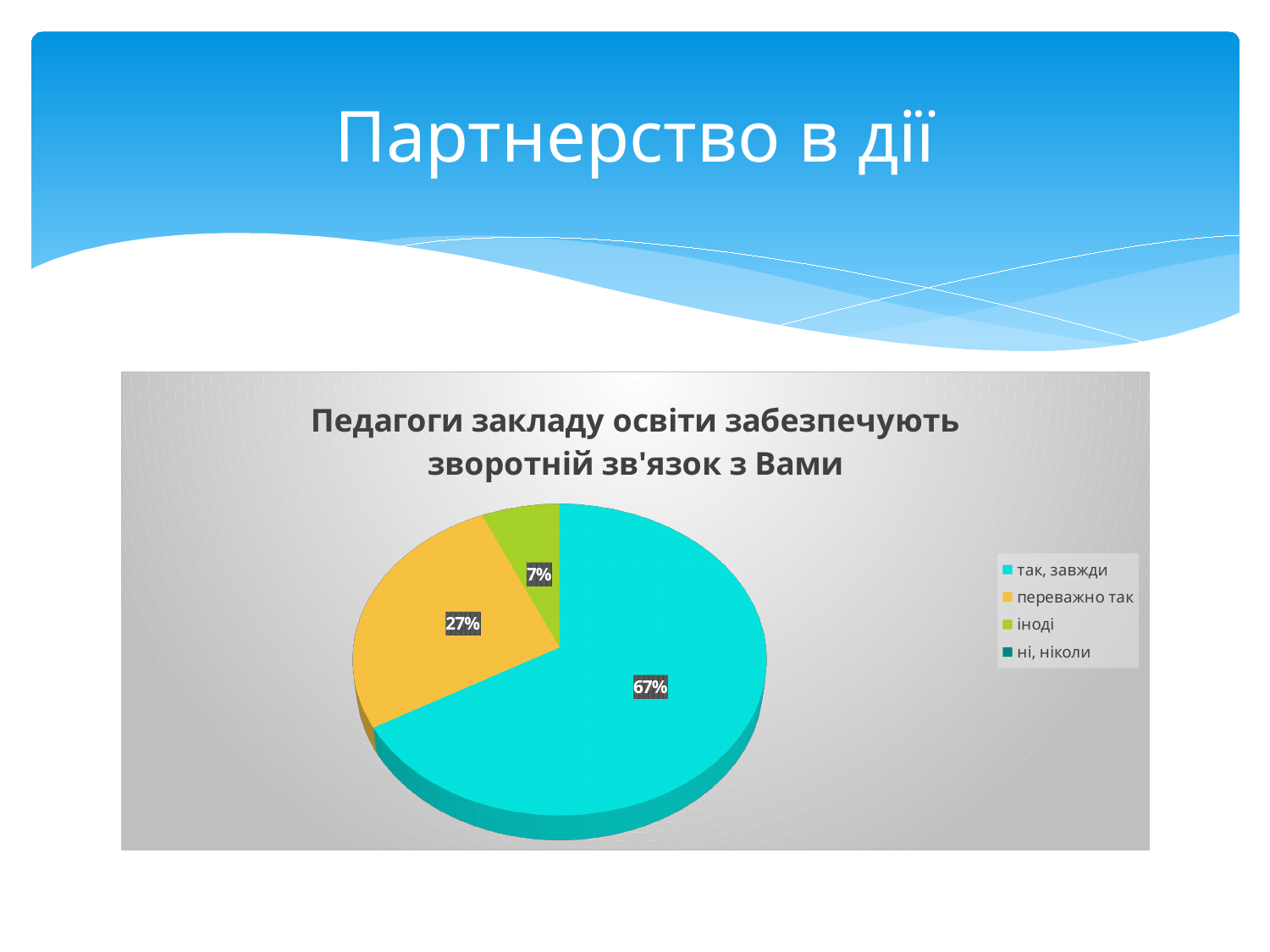
What is the title of the chart? Педагоги закладу освіти забезпечують зворотній зв'язок з Вами What colour is the slice for "переважно так"? Orange/yellow How many entries does the legend list? 4 Which category has the largest slice of the pie? так, завжди Of the slices with printed labels, which category has the smallest share? іноді By how many percentage points does the "так, завжди" share exceed the "переважно так" share? 40 percentage points What kind of chart is shown on the slide? Pie chart What share of the pie is labelled for "так, завжди"? 67% What percentage is shown for the "іноді" slice? 7% What percentage is shown for the "переважно так" slice? 27% Which is larger: the share for "переважно так" or the share for "іноді"? переважно так How many slices have a percentage label printed on the pie? 3